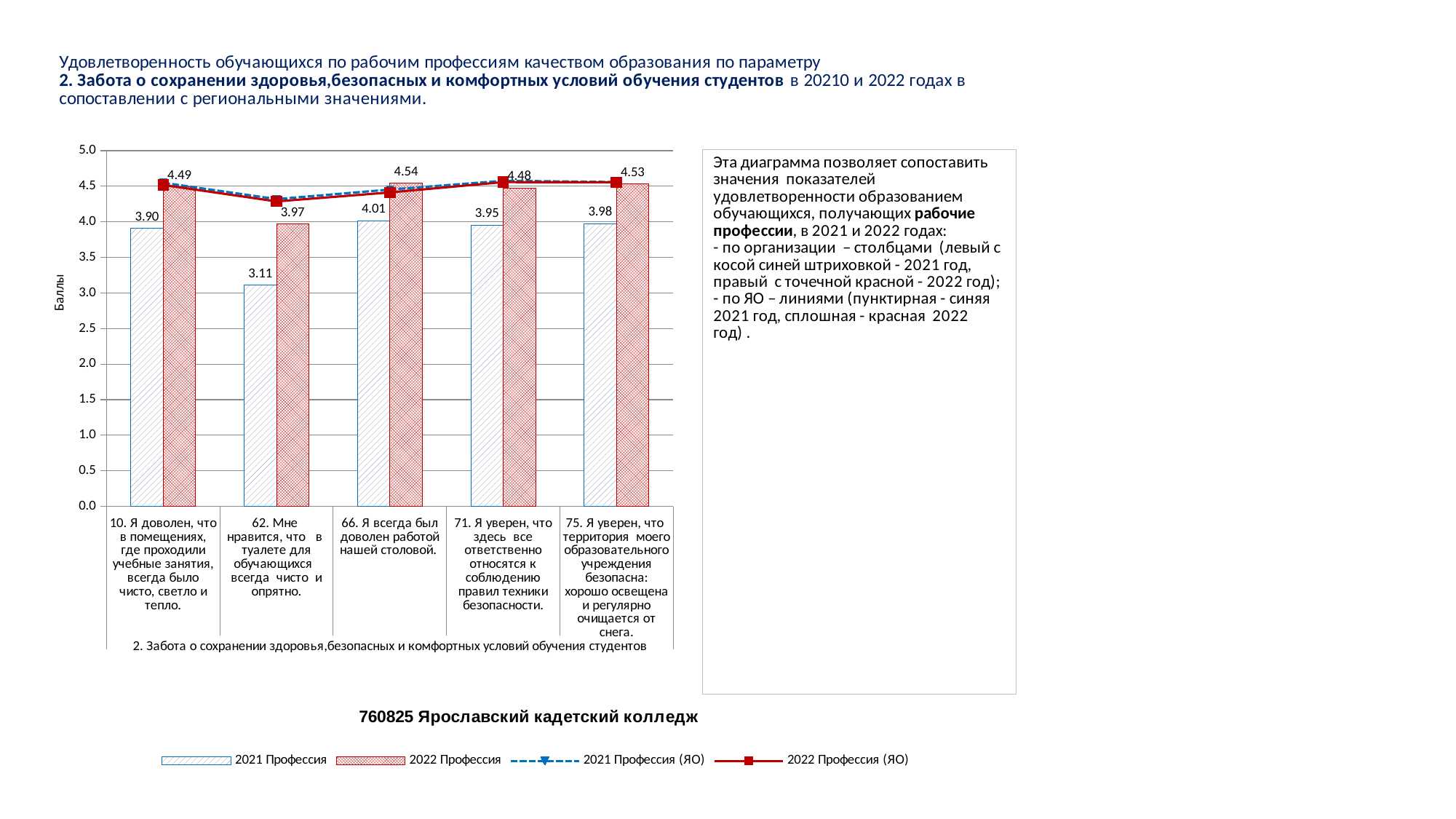
Is the 2022 Профессия (ЯО) line value for question 62 greater or less than 4.5? less Which question has the highest 2022 Профессия bar? 66. Я всегда был доволен работой нашей столовой. What is the 2021 Профессия value for question 71 (Я уверен, что здесь все ответственно относятся к соблюдению правил техники безопасности)? 3.95 What is the 2021 Профессия value for question 62 (Мне нравится, что в туалете для обучающихся всегда чисто и опрятно)? 3.11 What is the 2022 Профессия value for question 66 (Я всегда был доволен работой нашей столовой)? 4.54 How many series does the legend list? 4 For question 62, how much higher is the 2022 Профессия value than the 2021 Профессия value? 0.86 Which is larger: the 2021 Профессия value for question 10 or for question 75? Question 75 (3.98) What is the label of the vertical axis? Баллы How many questions (categories) are shown on the x axis? 5 What kind of chart is this? Bar chart combined with line series Which question has the lowest 2021 Профессия bar? 62. Мне нравится, что в туалете для обучающихся всегда чисто и опрятно.